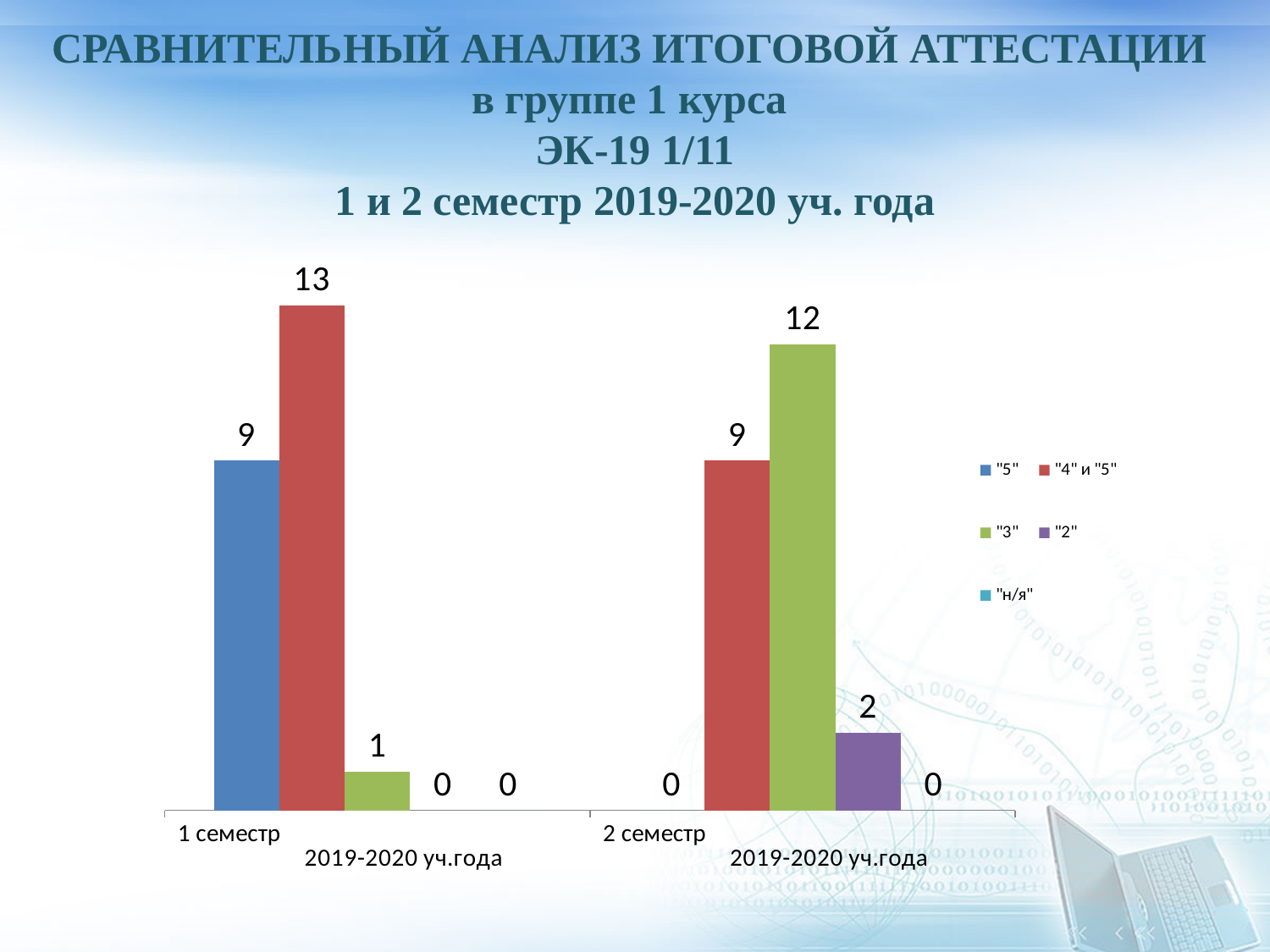
Which series has the highest value in 2 семестр 2019-2020 уч.года? "3" Which series has the highest value in 1 семестр 2019-2020 уч.года? "4" и "5" What is the value for "5" in 2 семестр 2019-2020 уч.года? 0 Which is larger: the "3" value in 1 семестр or the "3" value in 2 семестр? 2 семестр What kind of chart is shown on the slide? bar chart How many series does the legend list? 5 How many categories are shown on the x axis? 2 What is the value for "4" и "5" in 1 семестр 2019-2020 уч.года? 13 What is the value for "2" in 2 семестр 2019-2020 уч.года? 2 What is the value for "3" in 2 семестр 2019-2020 уч.года? 12 What is the value for "5" in 1 семестр 2019-2020 уч.года? 9 What is the difference between the "4" и "5" values in 1 семестр and 2 семестр? 4